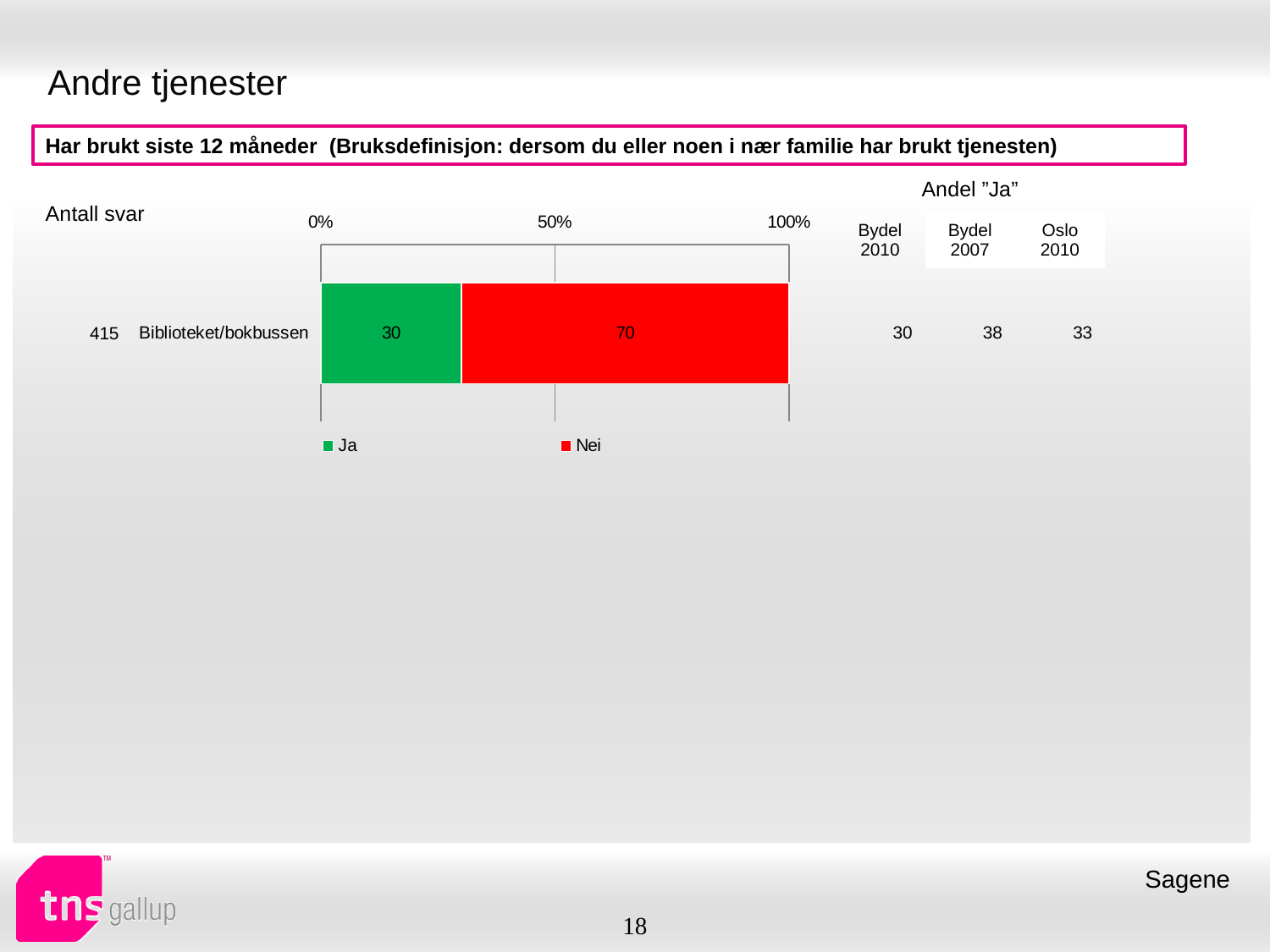
How many series does the legend list? 2 Is the "Nei" value for Biblioteket/bokbussen greater or less than 50%? greater How many categories are plotted in the chart? 1 What is the total of the stacked bar for Biblioteket/bokbussen? 100 What is the difference between the Nei and Ja values for Biblioteket/bokbussen? 40 What is the value of the "Nei" segment for Biblioteket/bokbussen? 70 What is the number of responses (Antall svar) shown for Biblioteket/bokbussen? 415 Which segment is larger for Biblioteket/bokbussen, Ja or Nei? Nei Is the "Ja" value for Biblioteket/bokbussen greater or less than 50%? less What kind of chart is shown on the slide? Stacked bar chart What is the value of the "Ja" segment for Biblioteket/bokbussen? 30 What colour represents "Ja" in the chart? Green